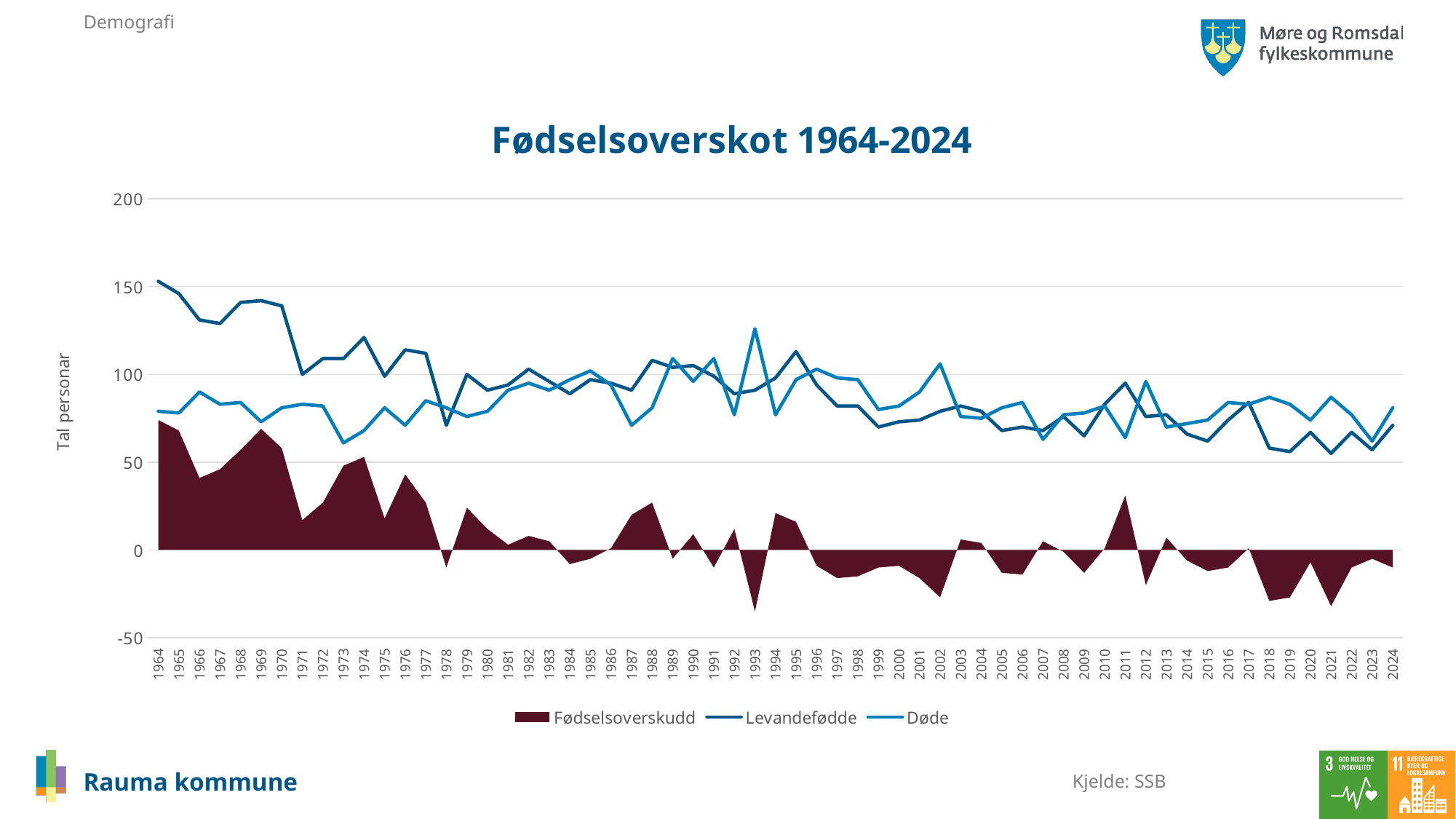
Does the Levandefødde series generally rise or fall from 1964 to 2024? fall In which year is the Levandefødde series at its highest? 1964 Is the value for Levandefødde in 2024 greater or less than 100? less What is the label of the vertical axis? Tal personar How many years are plotted along the x axis? 61 How many series does the legend list? 3 Is the value for Døde in 1993 greater or less than 100? greater In 1964, which is larger: Levandefødde or Døde? Levandefødde In which year does the Døde series reach its highest value? 1993 Is the value for Fødselsoverskudd in 2021 greater or less than 0? less What is the title of the chart? Fødselsoverskot 1964-2024